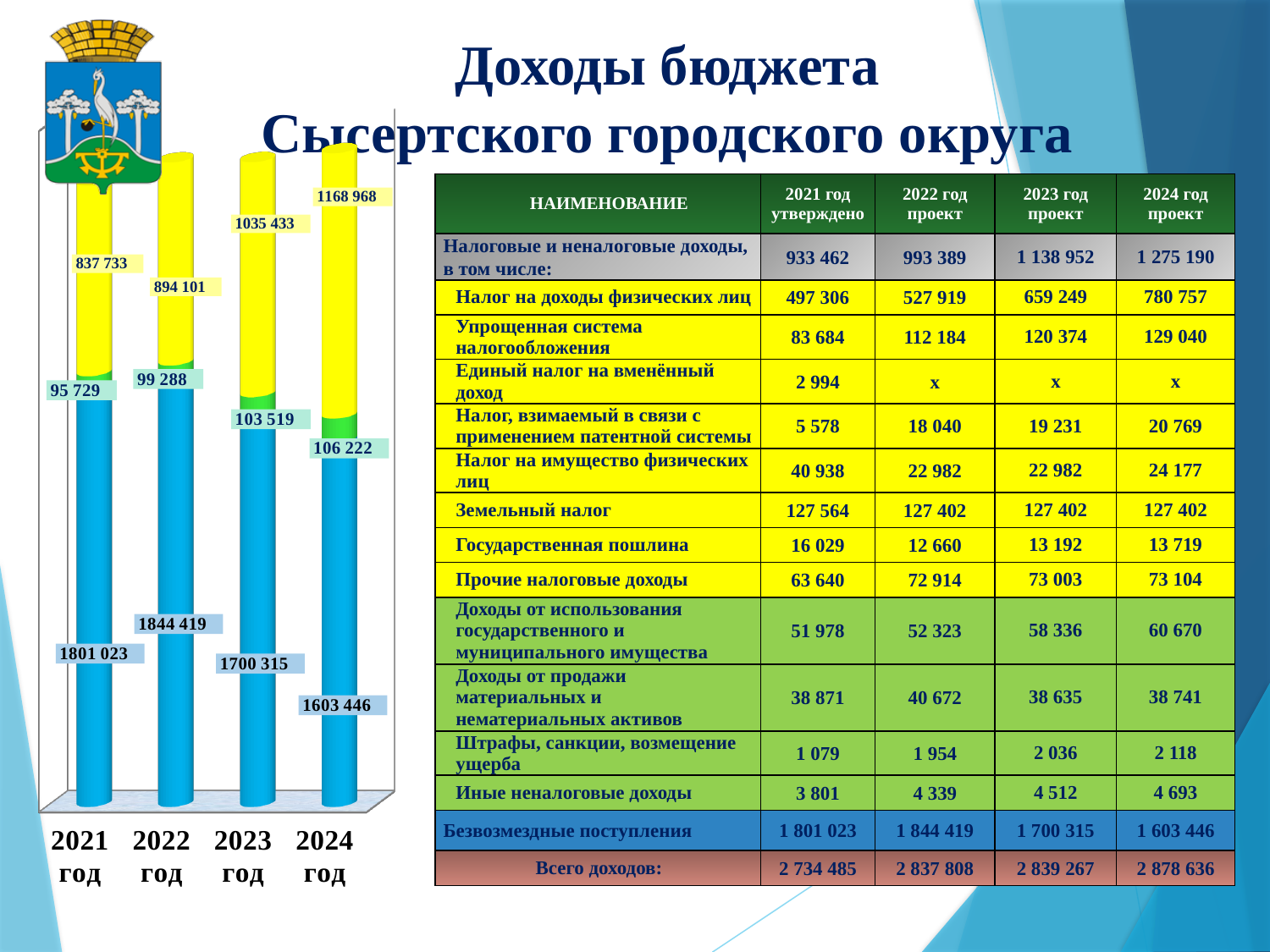
What is the value of the yellow segment for 2024 год in the bar chart? 1168 968 Do the yellow segment values in the bar chart rise or fall from 2021 год to 2024 год? rise What is the total of the stacked bar for 2021 год in the bar chart? 2 734 485 What is the value of the blue segment for 2021 год in the bar chart? 1801 023 In the bar chart, which year has the lowest value for the blue segment? 2024 год In the bar chart, which year has the highest value for the yellow segment? 2024 год In the bar chart, is the blue segment larger for 2022 год or for 2023 год? 2022 год What type of chart is shown on the left of the slide? bar chart In the bar chart, what is the difference between the yellow segment values for 2024 год and 2023 год? 133 535 In the bar chart, which year has the lowest value for the green segment? 2021 год How many years (categories) are shown on the x axis of the bar chart? 4 What is the value of the green segment for 2023 год in the bar chart? 103 519